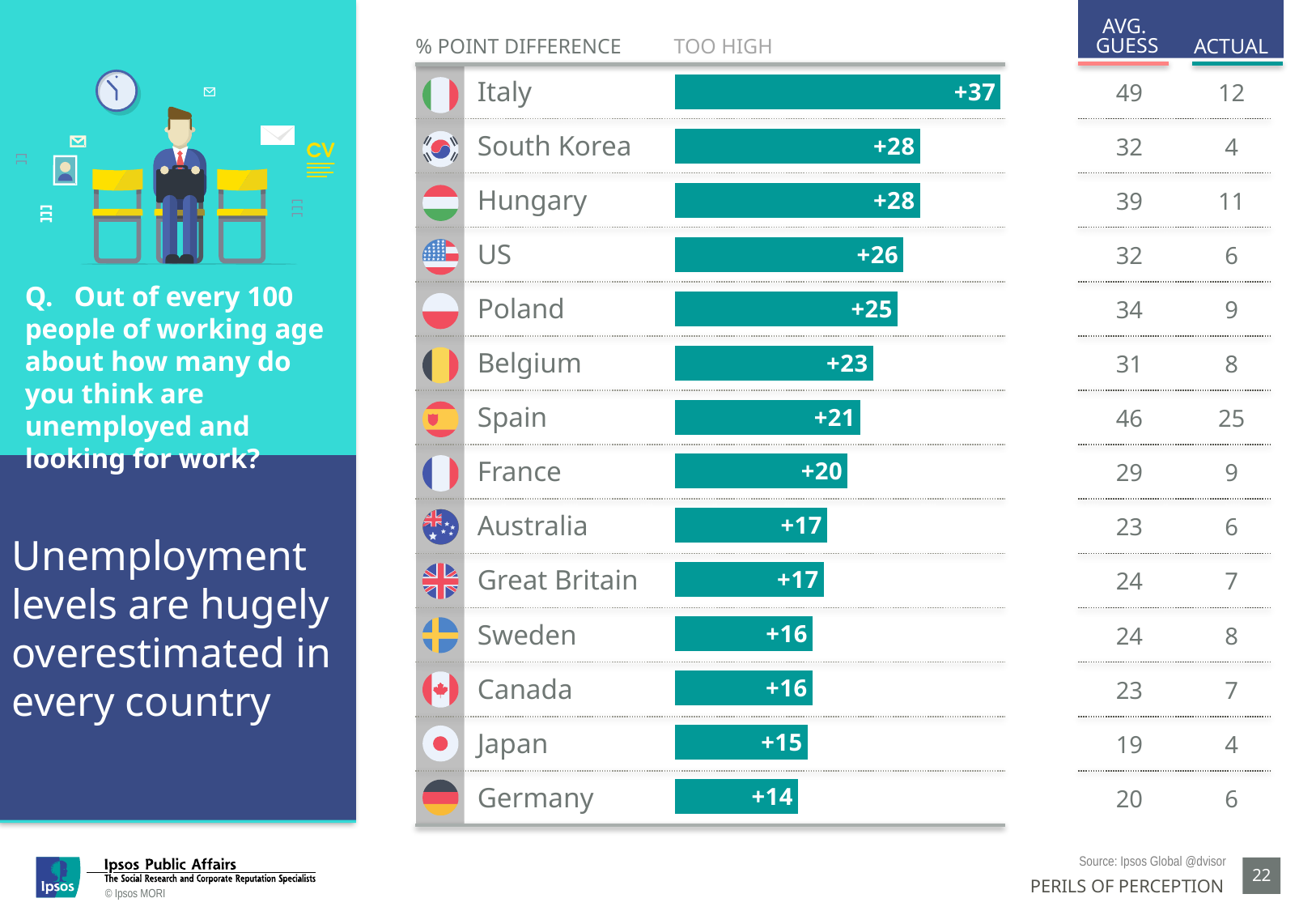
What is the actual value for Japan in the table? 4 Which has a larger % point difference, US or France? US What label appears above the bars in the chart header? TOO HIGH What is the % point difference shown for Italy? +37 Which country has the lowest % point difference? Germany What is the average guess for Spain in the table? 46 Which country has the highest % point difference? Italy What is the % point difference shown for Spain? +21 What is the difference between the % point difference for Italy and for Germany? 23 How many countries are shown in the bar chart? 14 What kind of chart is used to show the % point difference? Bar chart Do the % point difference values rise or fall going down the list from Italy to Germany? Fall